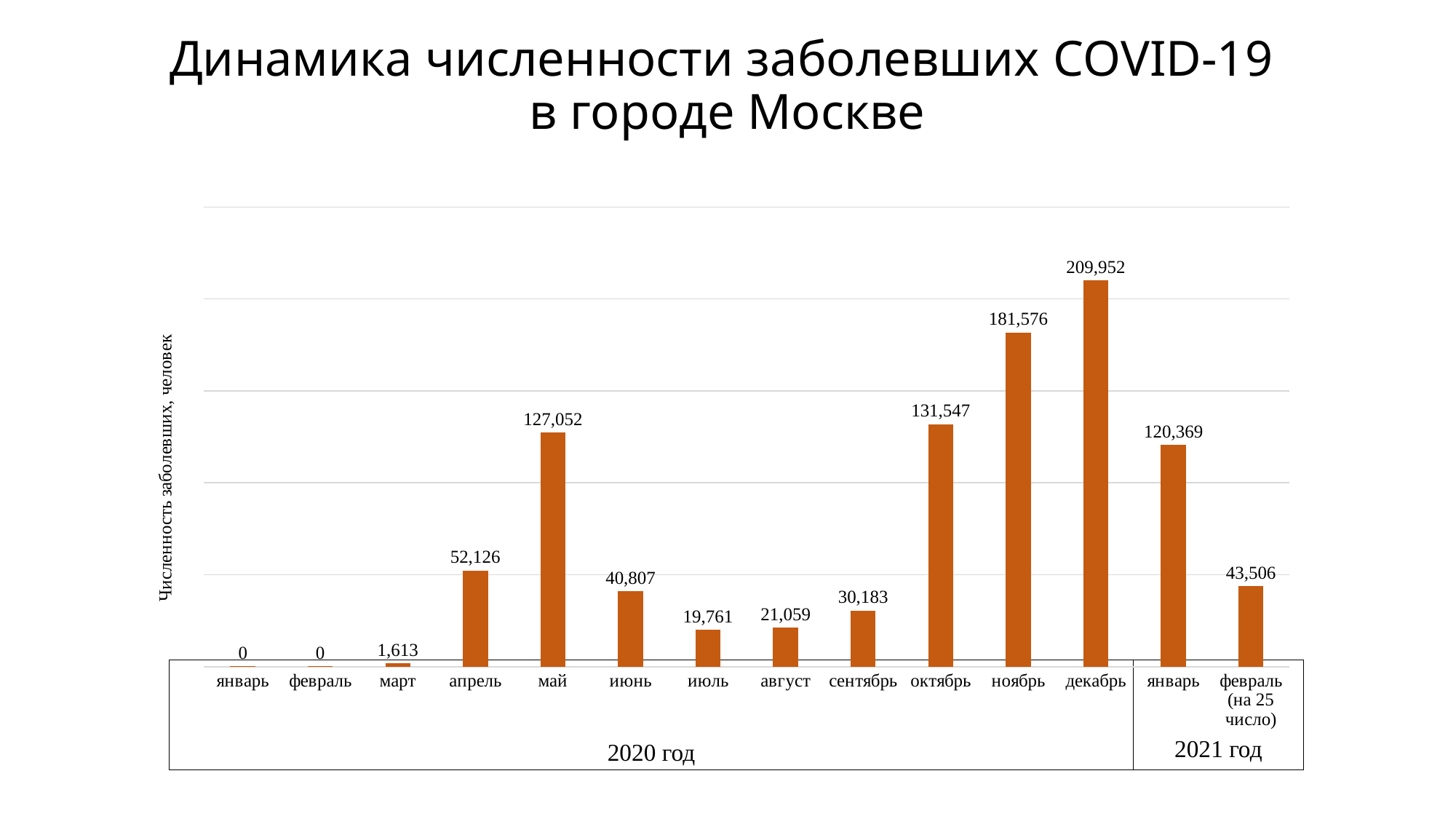
What is the value for декабрь 2020? 209,952 How many months (bars) are shown on the chart? 14 Which month in 2020 has the highest value among the months from июнь to сентябрь? июнь What is the difference between the values for декабрь 2020 and ноябрь 2020? 28,376 What kind of chart is shown on the slide? bar chart What is the value for май 2020? 127,052 Which is larger, the value for октябрь 2020 or the value for май 2020? октябрь 2020 What is the value for февраль (на 25 число) 2021? 43,506 Do the values rise or fall from сентябрь 2020 to декабрь 2020? rise What is the value for март 2020? 1,613 Which month has the highest value? декабрь 2020 What is the difference between the values for январь 2021 and февраль 2021? 76,863